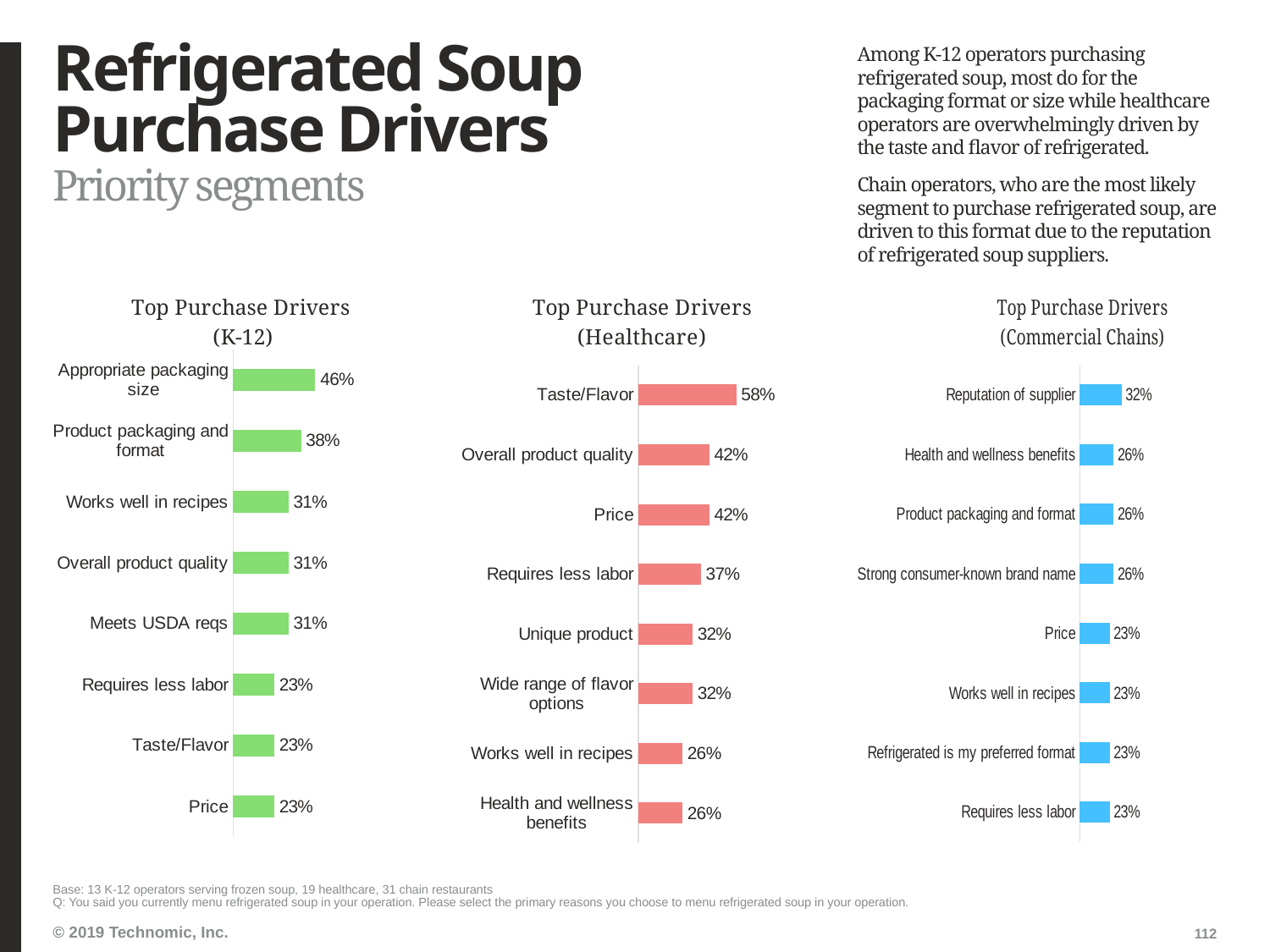
In the Top Purchase Drivers (K-12) chart, what is the value for Appropriate packaging size? 46% In the Top Purchase Drivers (Healthcare) chart, which category has the highest value? Taste/Flavor In the Top Purchase Drivers (Healthcare) chart, what is the difference between Taste/Flavor and Overall product quality? 16% What kind of chart is the Top Purchase Drivers (Healthcare) chart? Bar chart What colour are the bars in the Top Purchase Drivers (Commercial Chains) chart? Blue How many categories are shown in the Top Purchase Drivers (Commercial Chains) chart? 8 In the Top Purchase Drivers (K-12) chart, what is the difference between Appropriate packaging size and Product packaging and format? 8% How many categories are shown in the Top Purchase Drivers (K-12) chart? 8 In the Top Purchase Drivers (Commercial Chains) chart, which is larger: Reputation of supplier or Price? Reputation of supplier In the Top Purchase Drivers (Healthcare) chart, what is the value for Requires less labor? 37% In the Top Purchase Drivers (Commercial Chains) chart, what is the value for Reputation of supplier? 32% In the Top Purchase Drivers (K-12) chart, which category has the highest value? Appropriate packaging size